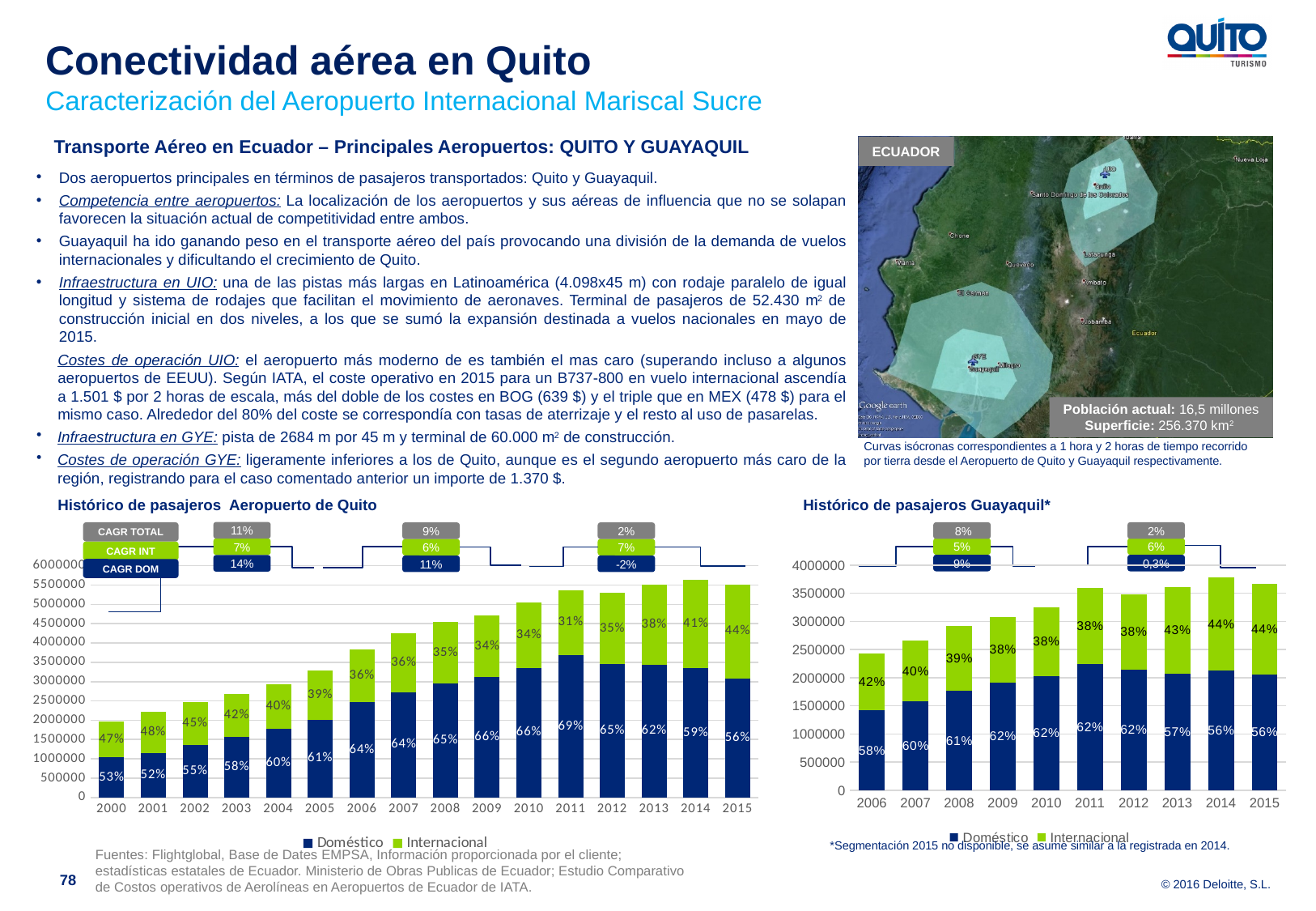
In the 'Histórico de pasajeros Aeropuerto de Quito' chart, does the Internacional share rise or fall from 2011 to 2015? rise In the 'Histórico de pasajeros Aeropuerto de Quito' chart, what is the Internacional share in 2015? 44% Which is larger: the Doméstico share in 2000 in the Quito chart or the Doméstico share in 2006 in the Guayaquil chart? Doméstico share in 2006 in the Guayaquil chart In the 'Histórico de pasajeros Aeropuerto de Quito' chart, is the total number of passengers in 2015 greater or less than 5000000? greater How many series does the legend of the 'Histórico de pasajeros Aeropuerto de Quito' chart list? 2 In the 'Histórico de pasajeros Aeropuerto de Quito' chart, in which year is the Doméstico share highest? 2011 In the 'Histórico de pasajeros Aeropuerto de Quito' chart, in which year is the Internacional share lowest? 2011 In the 'Histórico de pasajeros Aeropuerto de Quito' chart, what percentage of passengers in 2011 were Doméstico? 69% In the 'Histórico de pasajeros Guayaquil*' chart, what is the Internacional share in 2013? 43% In the 'Histórico de pasajeros Aeropuerto de Quito' chart, how many percentage points higher is the Doméstico share than the Internacional share in 2015? 12 percentage points How many years are shown on the x axis of the 'Histórico de pasajeros Guayaquil*' chart? 10 In the 'Histórico de pasajeros Guayaquil*' chart, what is the Doméstico share in 2006? 58%